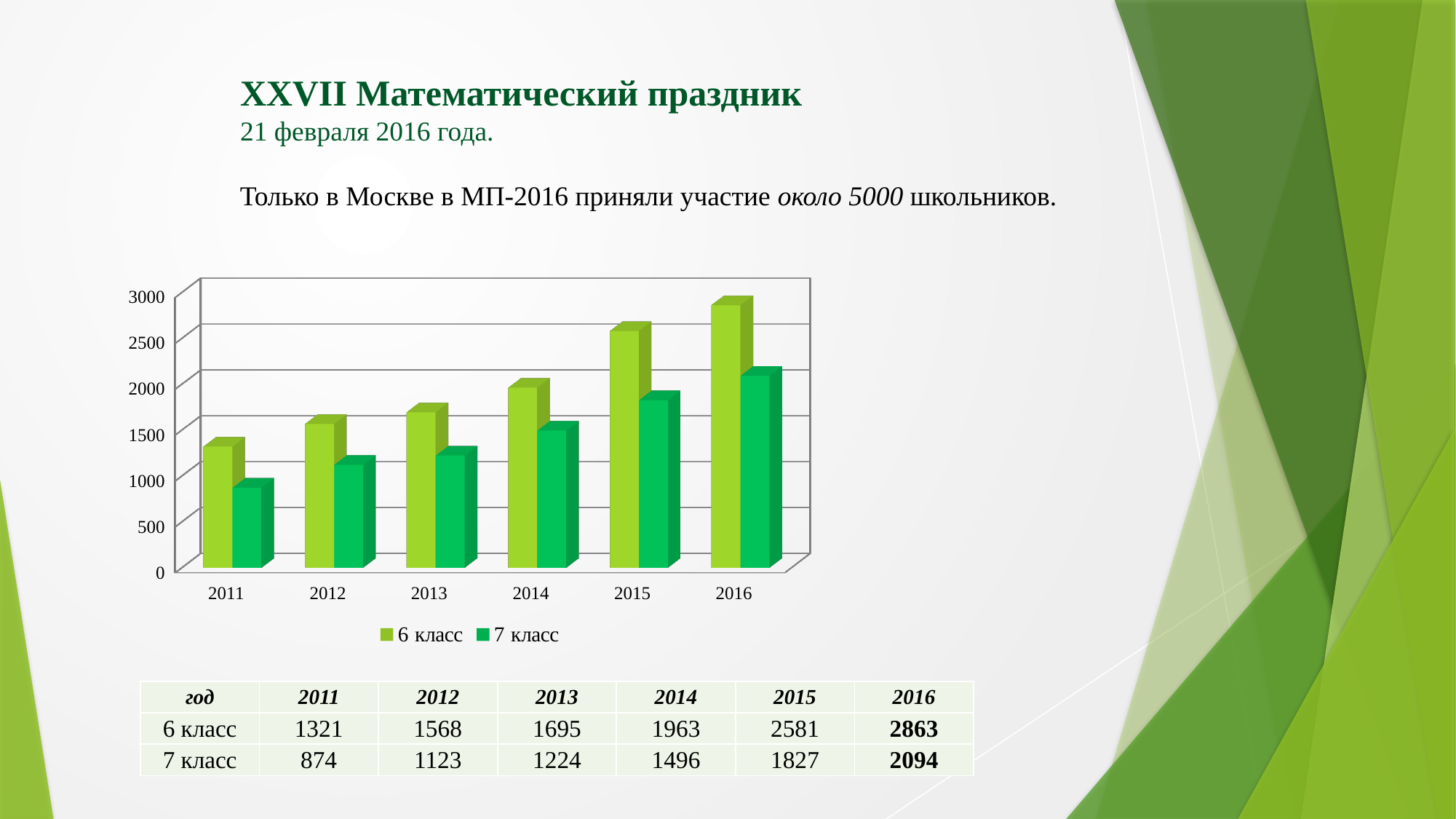
In which year is the value for 6 класс highest? 2016 What is the difference between 6 класс and 7 класс in 2015? 754 Which is larger in 2013: the value for 6 класс or for 7 класс? 6 класс How many years are shown on the x axis of the chart? 6 What is the value for 6 класс in 2016? 2863 What is the value for 7 класс in 2011? 874 Is the value for 7 класс in 2016 greater or less than 2000? greater What kind of chart is shown on the slide? bar chart How many series does the chart legend list? 2 What is the value for 7 класс in 2014? 1496 Do the values for 6 класс rise or fall from 2011 to 2016? rise In which year is the value for 7 класс lowest? 2011